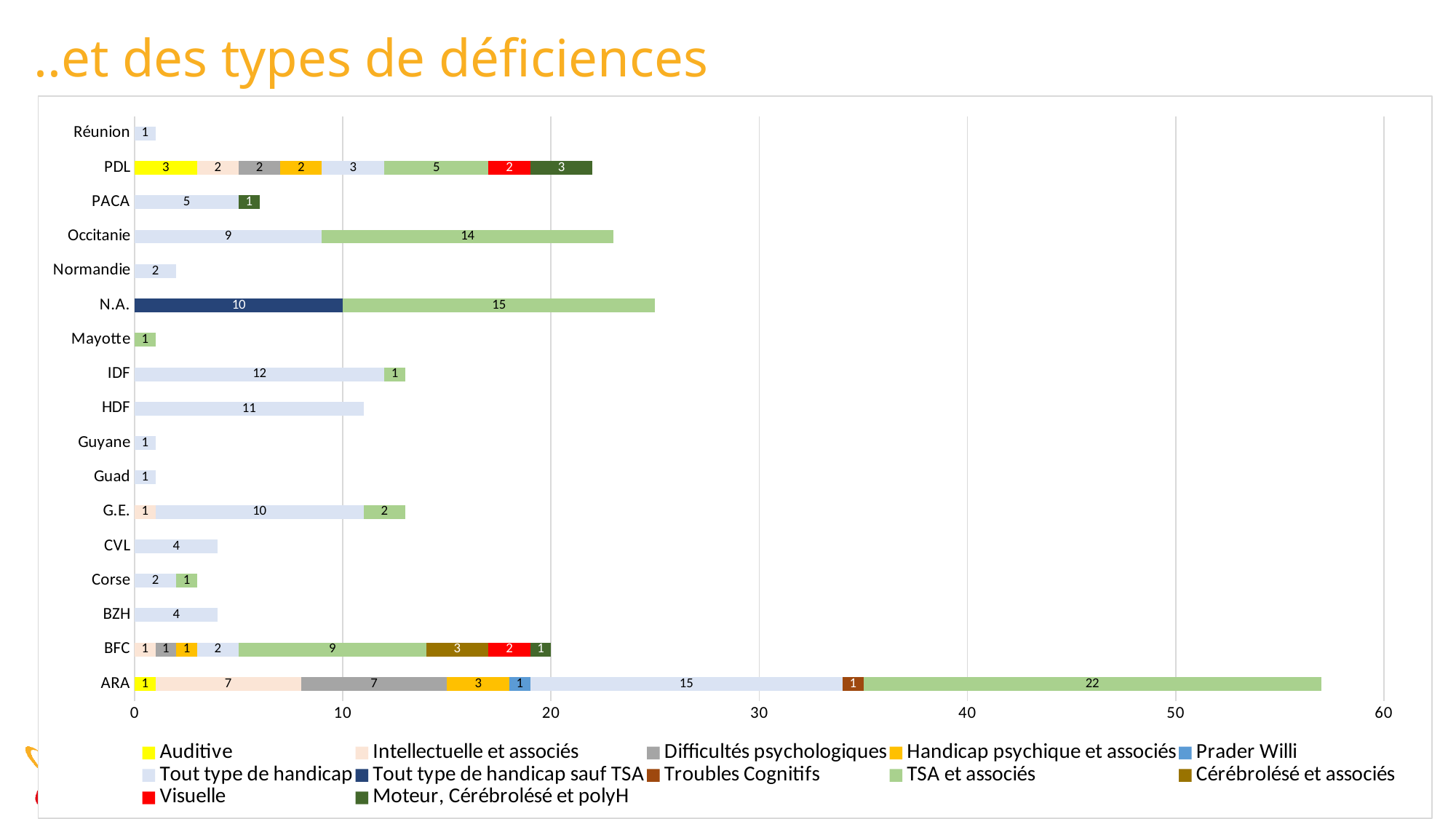
What is the total of the stacked bar for N.A.? 25 Which is larger: the 'Tout type de handicap' value for IDF or for HDF? IDF How many series does the legend list? 12 Which region has the longest total bar? ARA What is the total of the stacked bar for Occitanie? 23 What is the value of the 'Tout type de handicap sauf TSA' segment for N.A.? 10 What is the value of the 'Tout type de handicap' segment for HDF? 11 Is the total bar for ARA greater or less than 50? greater How many regions (categories) are plotted on the chart? 17 What is the value of the 'TSA et associés' segment for ARA? 22 What is the difference between the 'TSA et associés' values for N.A. and Occitanie? 1 What kind of chart is shown on the slide? Stacked bar chart